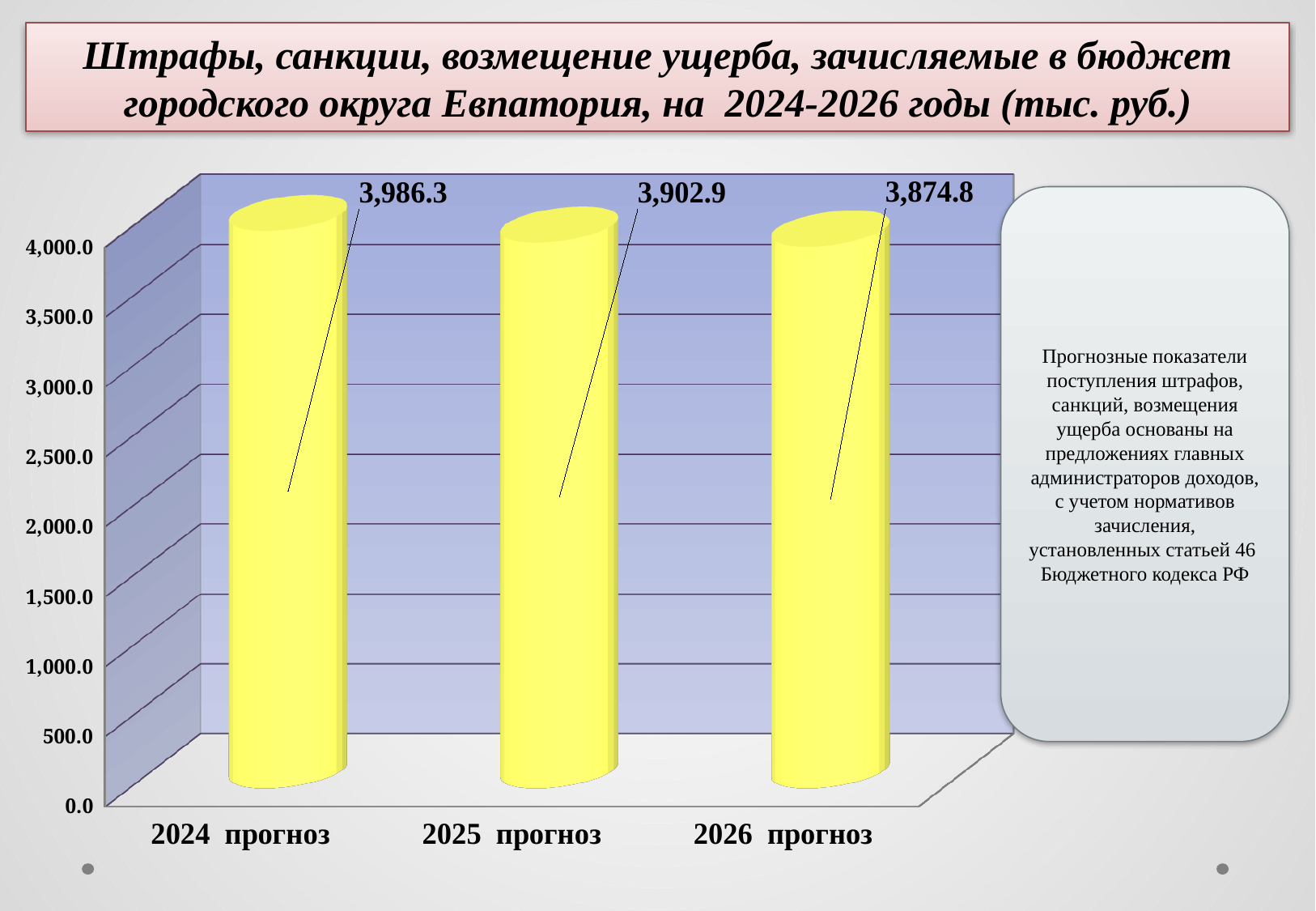
What is the value for 2025 прогноз? 3,902.9 Is the value for 2026 прогноз greater or less than 3,500.0? greater What kind of chart is shown on the slide? bar chart How many categories are shown on the x axis? 3 Do the values rise or fall from 2024 прогноз to 2026 прогноз? fall What is the difference between the values for 2024 прогноз and 2026 прогноз? 111.5 What is the value for 2024 прогноз? 3,986.3 What is the value for 2026 прогноз? 3,874.8 Which year has the highest value? 2024 прогноз Which year has the lowest value? 2026 прогноз What is the difference between the values for 2024 прогноз and 2025 прогноз? 83.4 Which is larger, the value for 2025 прогноз or 2026 прогноз? 2025 прогноз